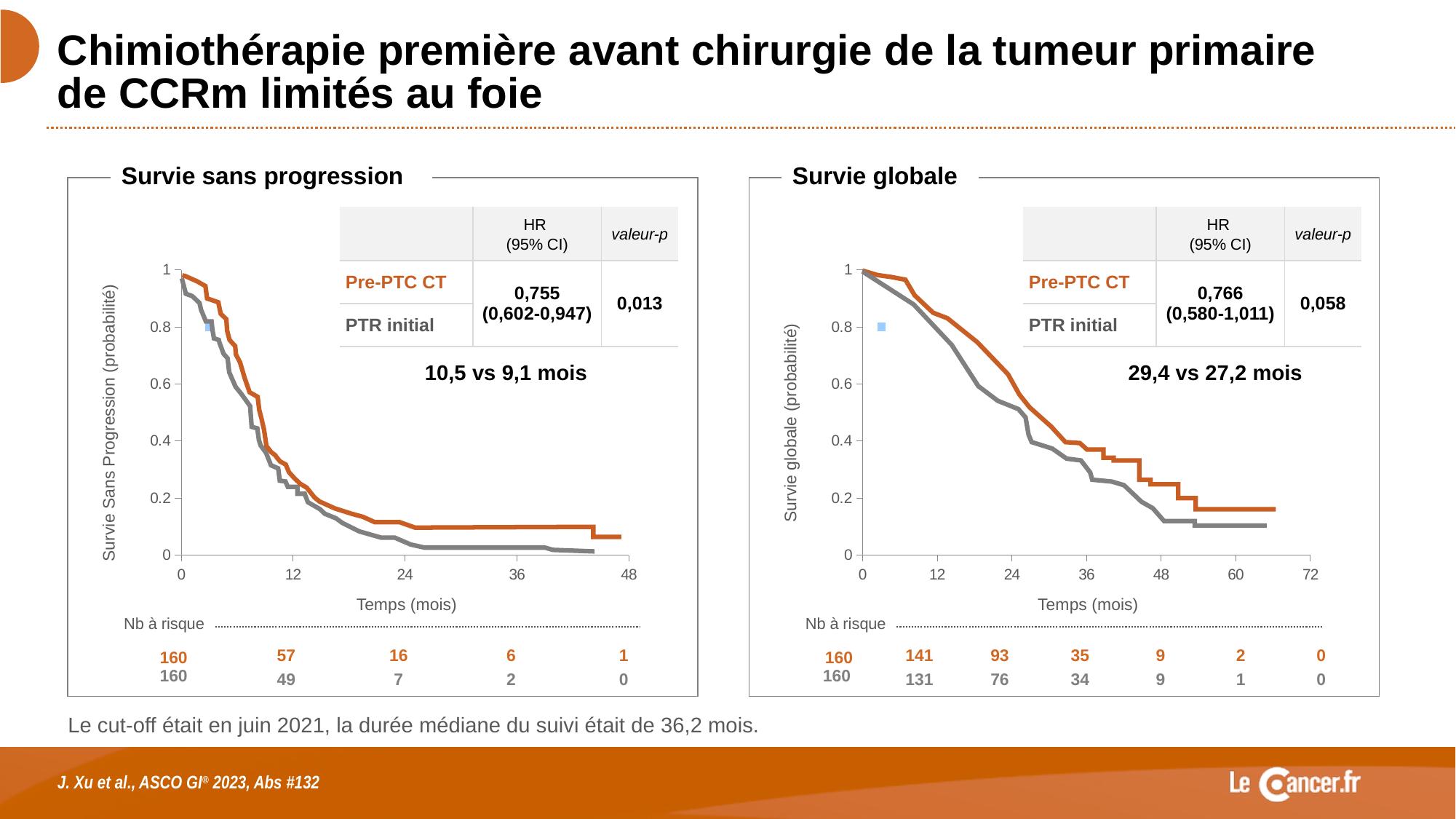
In the 'Survie globale' chart, how many patients are at risk in the Pre-PTC CT group at 12 months? 141 How many groups (series) are plotted in the 'Survie globale' chart? 2 In the 'Survie globale' chart, how many patients are at risk in the PTR initial group at 24 months? 76 What kind of chart is the 'Survie sans progression' chart? Line chart (Kaplan-Meier survival curve) In the 'Survie globale' chart, which group has more patients at risk at 36 months, Pre-PTC CT or PTR initial? Pre-PTC CT In the 'Survie sans progression' chart, what are the median values given as 'X vs Y mois'? 10,5 vs 9,1 mois In the 'Survie globale' chart, what is the valeur-p shown in the table? 0,058 In the 'Survie sans progression' chart, do the survival curves rise or fall as time increases? Fall In the 'Survie sans progression' chart, what is the HR (95% CI) shown in the table? 0,755 (0,602-0,947) In the 'Survie sans progression' chart, what is the difference between the number at risk at 12 months for Pre-PTC CT (57) and PTR initial (49)? 8 In the 'Survie globale' chart, is the Pre-PTC CT survival probability at 24 months greater or less than 0.4? greater In the 'Survie sans progression' chart, which colour is used for the Pre-PTC CT curve? Orange